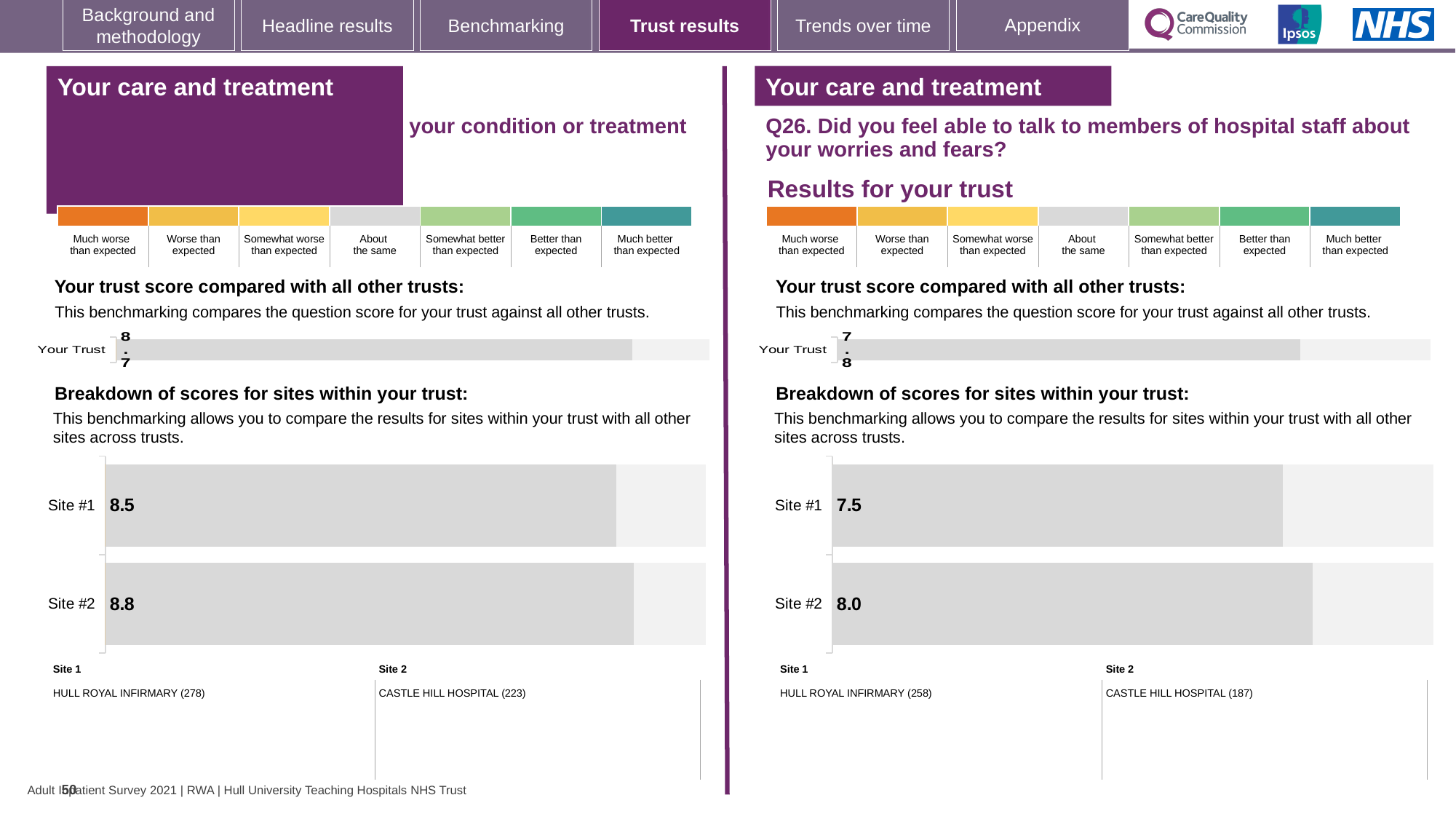
On the right-hand (Q26) site breakdown chart, what is the score for Site #1? 7.5 How many sites are shown on the right-hand (Q26) site breakdown chart? 2 On the left-hand site breakdown chart, which site has the lower score? Site #1 What type of chart is used for the site breakdown on the left-hand side of the slide? Bar chart On the right-hand (Q26) site breakdown chart, what is the difference between the Site #2 and Site #1 scores? 0.5 On the left-hand site breakdown chart, what is the score for Site #1? 8.5 On the left-hand site breakdown chart, what is the difference between the Site #2 and Site #1 scores? 0.3 On the right-hand (Q26) site breakdown chart, which site has the higher score? Site #2 On the right-hand (Q26) site breakdown chart, what is the score for Site #2? 8.0 On the right-hand (Q26) 'Your Trust' chart, what is the trust score shown? 7.8 On the left-hand site breakdown chart, what is the score for Site #2? 8.8 On the left-hand 'Your Trust' chart, what is the trust score shown? 8.7